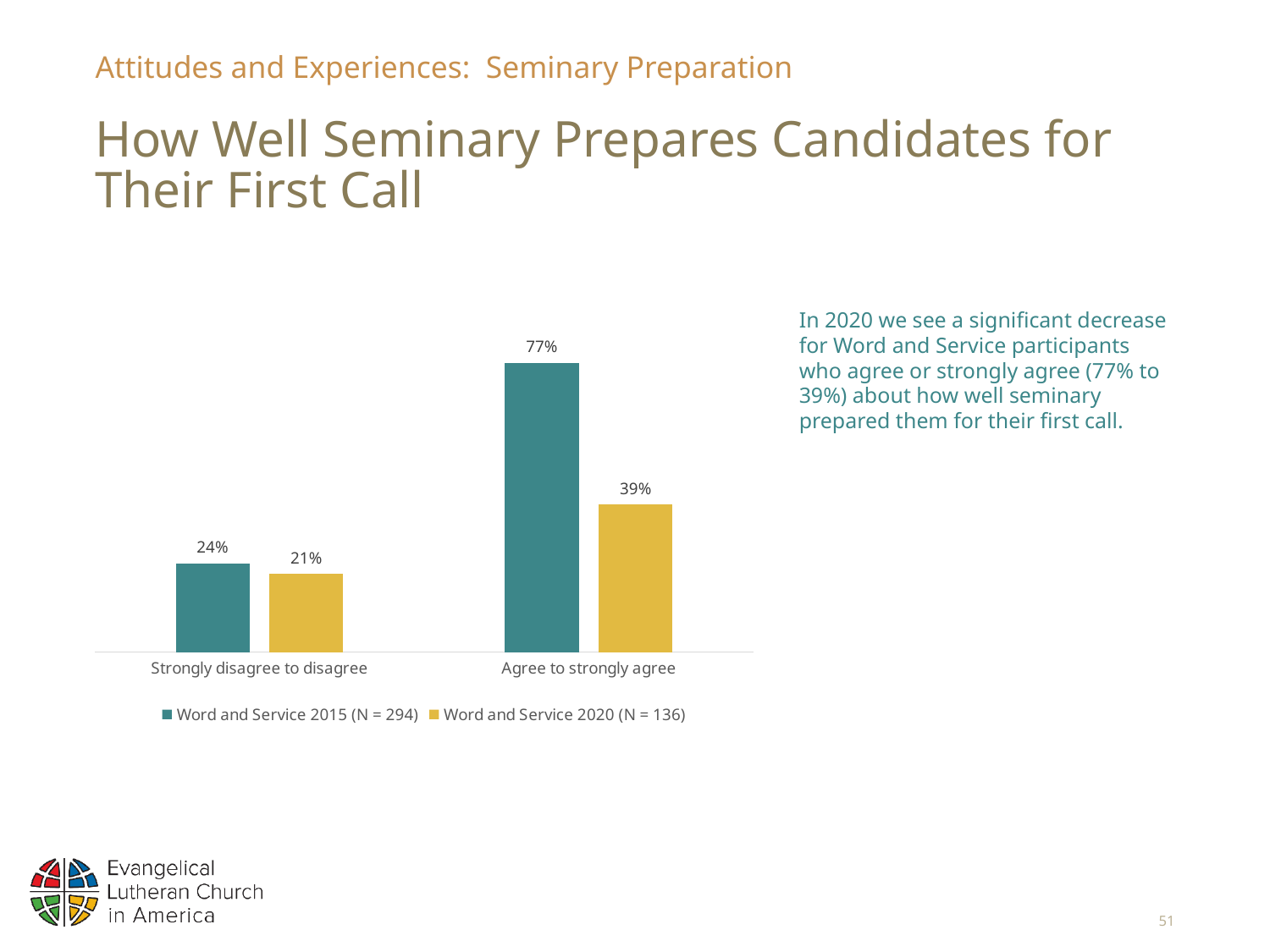
What is the value for Word and Service 2015 (N = 294) in the 'Strongly disagree to disagree' category? 24% In the 'Agree to strongly agree' category, which series has the larger value, Word and Service 2015 or Word and Service 2020? Word and Service 2015 (N = 294) Which bar has the highest value on the chart? Word and Service 2015 (N = 294), Agree to strongly agree What kind of chart is shown on the slide? Bar chart How many series does the chart legend list? 2 Which bar has the lowest value on the chart? Word and Service 2020 (N = 136), Strongly disagree to disagree What is the value for Word and Service 2020 (N = 136) in the 'Strongly disagree to disagree' category? 21% How many categories are shown on the x axis of the chart? 2 What is the value for Word and Service 2015 (N = 294) in the 'Agree to strongly agree' category? 77% What is the difference between the 2015 and 2020 values in the 'Strongly disagree to disagree' category? 3% What is the value for Word and Service 2020 (N = 136) in the 'Agree to strongly agree' category? 39% What is the difference between the 2015 and 2020 values in the 'Agree to strongly agree' category? 38%